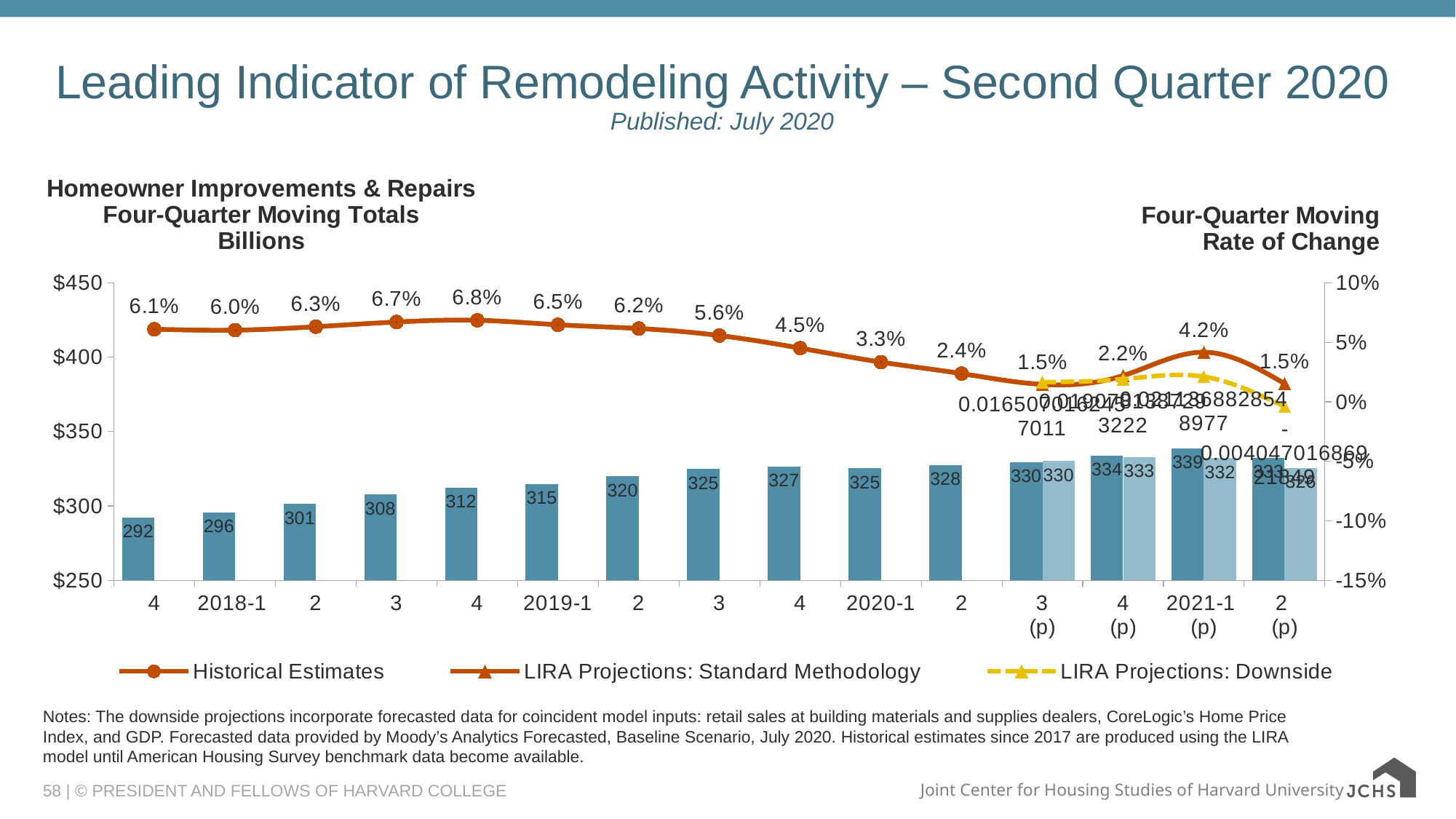
What is the value of the lowest dark blue bar on the chart? 292 What kind of chart is this? Combination bar and line chart What is the highest Historical Estimates rate of change shown on the chart? 6.8% Which legend entry is drawn as a dashed yellow line? LIRA Projections: Downside Does the Historical Estimates rate of change rise or fall from 2019-1 through 2020 quarter 2? Fall What is the four-quarter moving total (in billions) shown on the bar for 2018-1? 296 What is the LIRA Projections: Standard Methodology rate of change for 2021-1 (p)? 4.2% What is the Historical Estimates rate of change for 2019-1? 6.5% How many series does the legend list? 3 Which has a higher Historical Estimates rate of change: 2020-1 or the following quarter 2? 2020-1 How many quarter categories are shown along the x axis? 15 What is the difference between the dark blue bar values for 2020-1 and 2019-1? 10